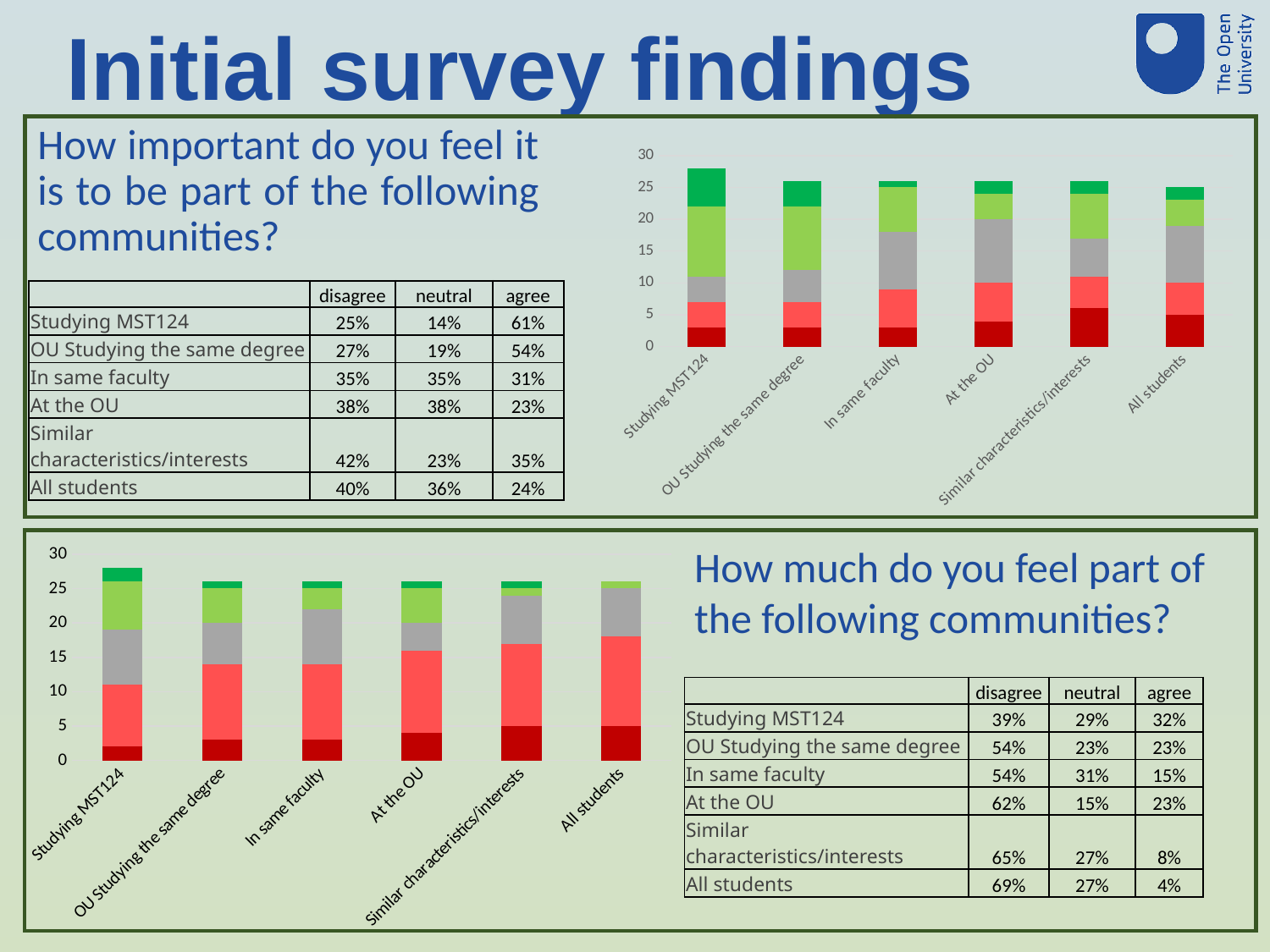
In the top-right chart, is the total height of the bar for Studying MST124 greater or less than 25? greater How many categories are shown on the x axis of the bottom-left chart? 6 In the top-right chart, is the total height of the bar for All students greater or less than 20? greater In the top-right chart, which category has the tallest stacked bar? Studying MST124 How many categories are shown on the x axis of the top-right chart? 6 What is the highest value shown on the vertical axis of the top-right chart? 30 In the bottom-left chart, is the total height of the bar for Studying MST124 greater or less than 30? less In the bottom-left chart, which category has the tallest stacked bar? Studying MST124 What kind of chart is the chart at the top right of the slide? Stacked bar chart What kind of chart is the chart at the bottom left of the slide? Stacked bar chart